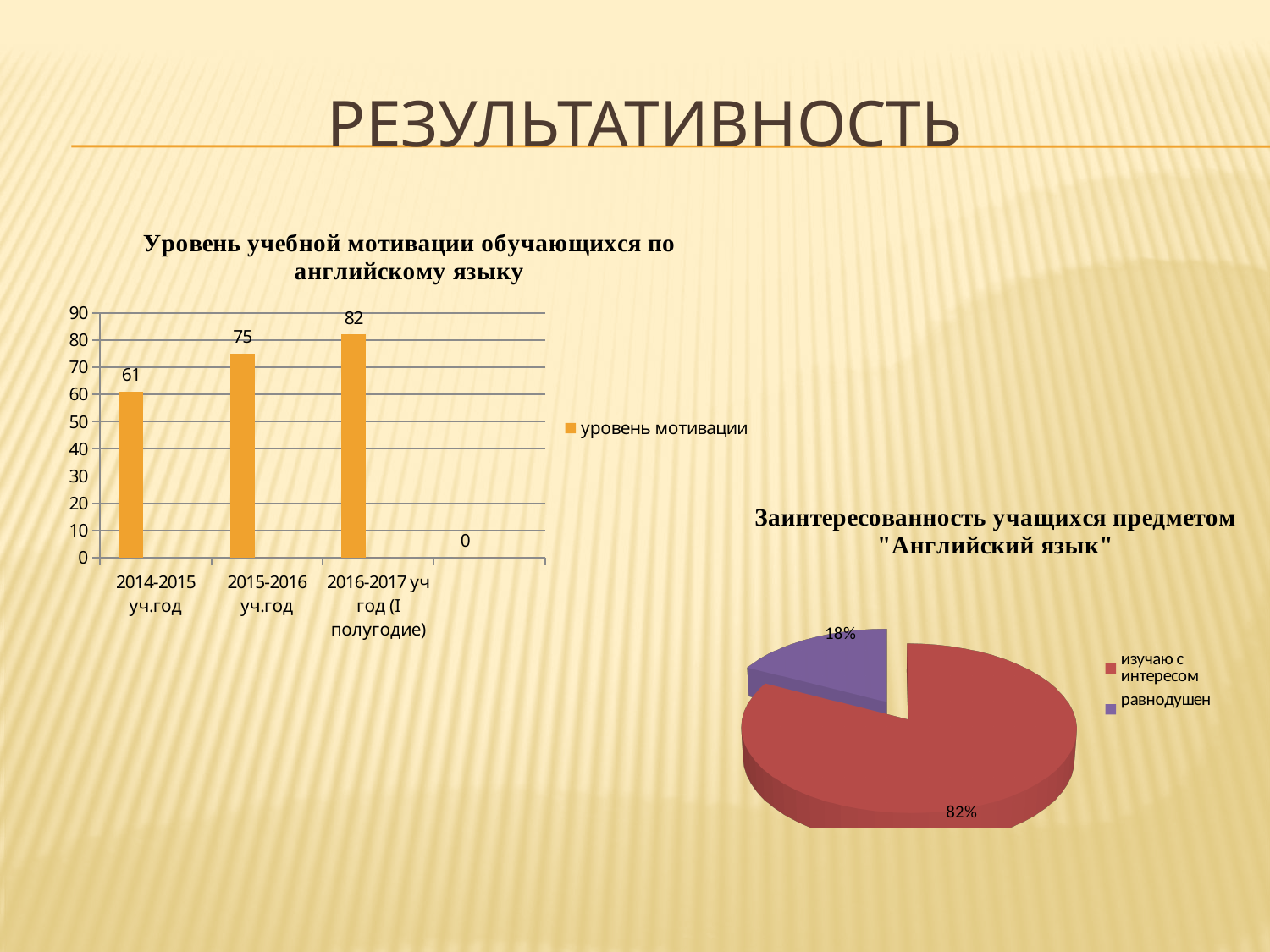
In the bar chart "Уровень учебной мотивации обучающихся по английскому языку", what is the value for 2015-2016 уч.год? 75 What kind of chart is the chart on the left of the slide? bar chart In the bar chart "Уровень учебной мотивации обучающихся по английскому языку", which labeled year has the highest value? 2016-2017 уч год (I полугодие) In the bar chart "Уровень учебной мотивации обучающихся по английскому языку", what is the value for 2014-2015 уч.год? 61 In the bar chart "Уровень учебной мотивации обучающихся по английскому языку", what is the difference between the values for 2016-2017 уч год (I полугодие) and 2014-2015 уч.год? 21 In the bar chart "Уровень учебной мотивации обучающихся по английскому языку", which labeled year has the lowest value? 2014-2015 уч.год In the bar chart "Уровень учебной мотивации обучающихся по английскому языку", do the values rise or fall from 2014-2015 to 2016-2017? rise In the bar chart "Уровень учебной мотивации обучающихся по английскому языку", how many series does the legend list? 1 In the pie chart "Заинтересованность учащихся предметом "Английский язык"", what share is "равнодушен"? 18% In the pie chart "Заинтересованность учащихся предметом "Английский язык"", what share is "изучаю с интересом"? 82% In the bar chart "Уровень учебной мотивации обучающихся по английскому языку", what is the value for 2016-2017 уч год (I полугодие)? 82 What kind of chart is "Заинтересованность учащихся предметом "Английский язык""? pie chart